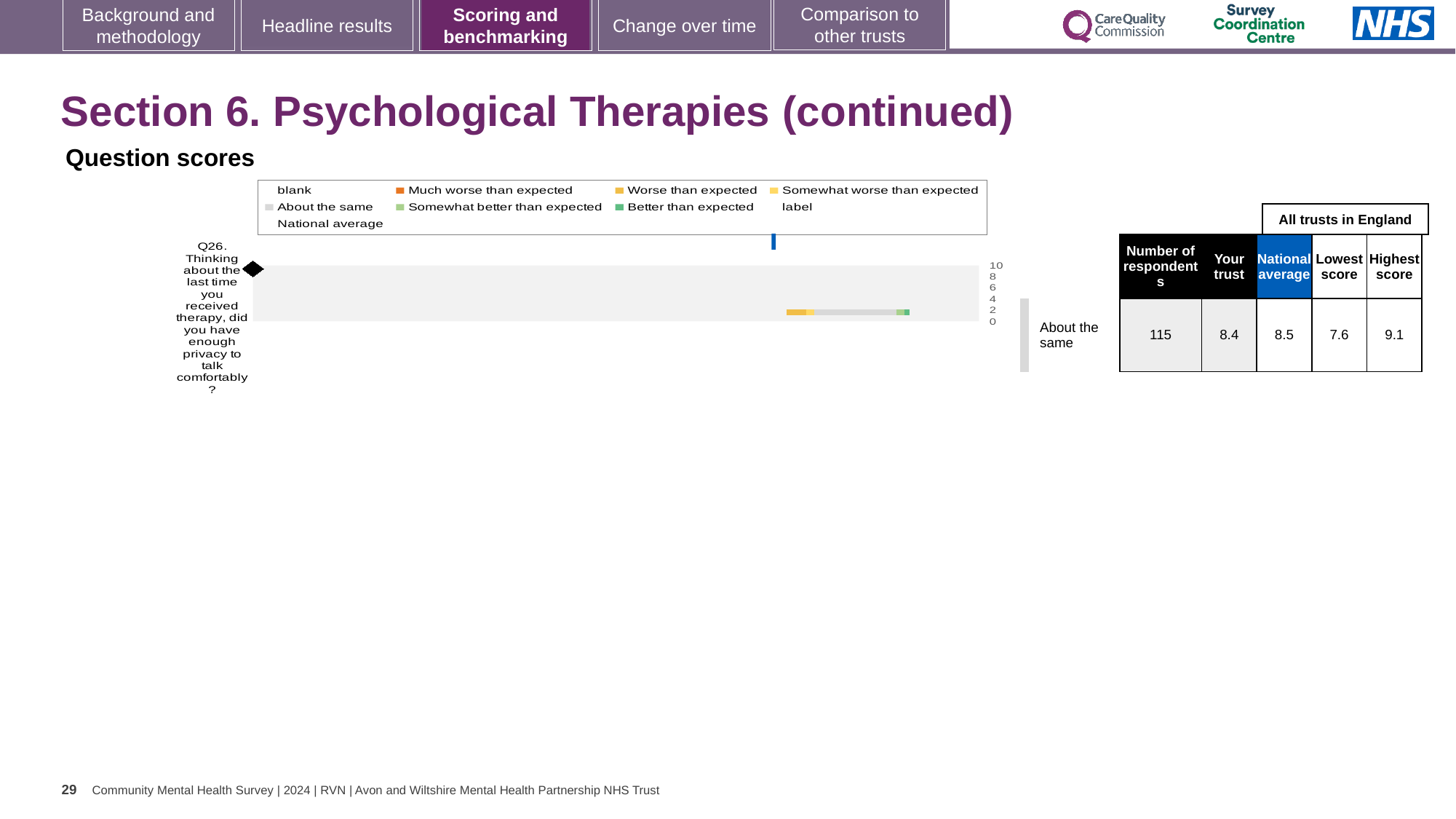
What kind of chart is used to show the Q26 question score? bar chart What is the difference between the highest and lowest scores for Q26 across all trusts in England? 1.5 Is the trust's score for Q26 greater or less than 8 on the chart axis? greater How many respondents answered Q26? 115 What is the lowest score among all trusts in England for Q26? 7.6 What is the national average score for Q26? 8.5 Which question is shown in the Question scores chart? Q26. Thinking about the last time you received therapy, did you have enough privacy to talk comfortably? What is the 'Your trust' score for Q26? 8.4 Which benchmark category does the trust's Q26 score fall into? About the same What is the highest score among all trusts in England for Q26? 9.1 How many questions are plotted in the Question scores chart? 1 Which is larger for Q26, the trust's score or the national average? National average